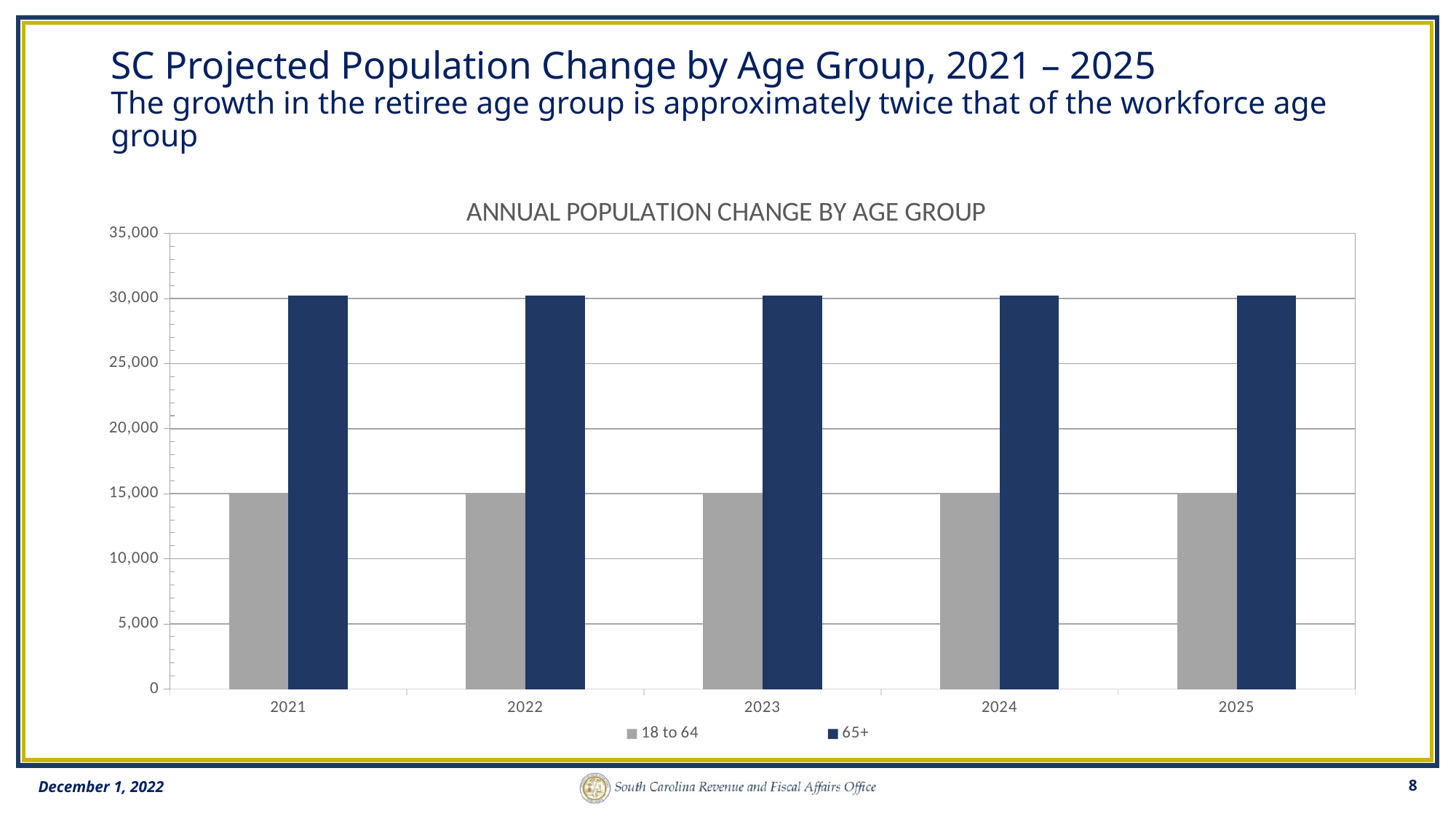
Is the value for 65+ in 2021 greater or less than 25,000? greater How many series does the legend list? 2 Do the values for the 65+ series rise, fall, or stay roughly flat from 2021 to 2025? stay roughly flat Is the value for 18 to 64 in 2022 greater or less than 10,000? greater What is the title of the chart? ANNUAL POPULATION CHANGE BY AGE GROUP Which colour represents the 18 to 64 series in the legend? gray What kind of chart is shown on the slide? bar chart Is the value for 18 to 64 in 2024 greater or less than 20,000? less Which series has the smaller value in 2025, 18 to 64 or 65+? 18 to 64 How many years are shown on the x axis? 5 Which series has the larger value in 2023, 18 to 64 or 65+? 65+